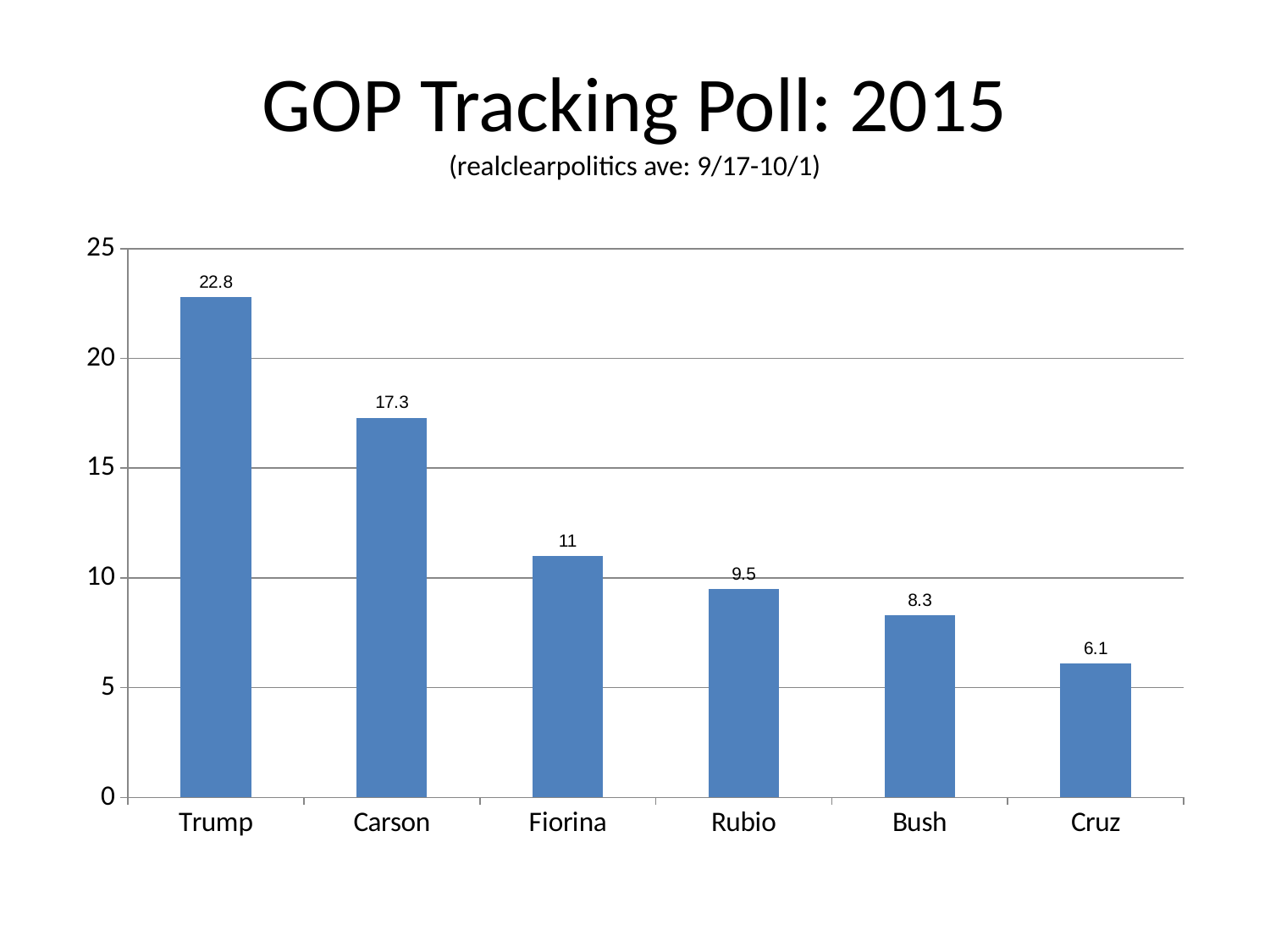
What is the difference between the values for Rubio and Cruz? 3.4 What is the value for Fiorina? 11 Which candidate has the highest value? Trump Do the values rise or fall from left to right across the candidates? fall Which candidate has the lowest value? Cruz Is the value for Rubio greater or less than 10? less What is the value for Trump? 22.8 How many candidates are shown on the chart? 6 What kind of chart is shown on the slide? bar chart What is the value for Bush? 8.3 Which is larger, the value for Carson or the value for Fiorina? Carson What is the difference between the values for Trump and Carson? 5.5